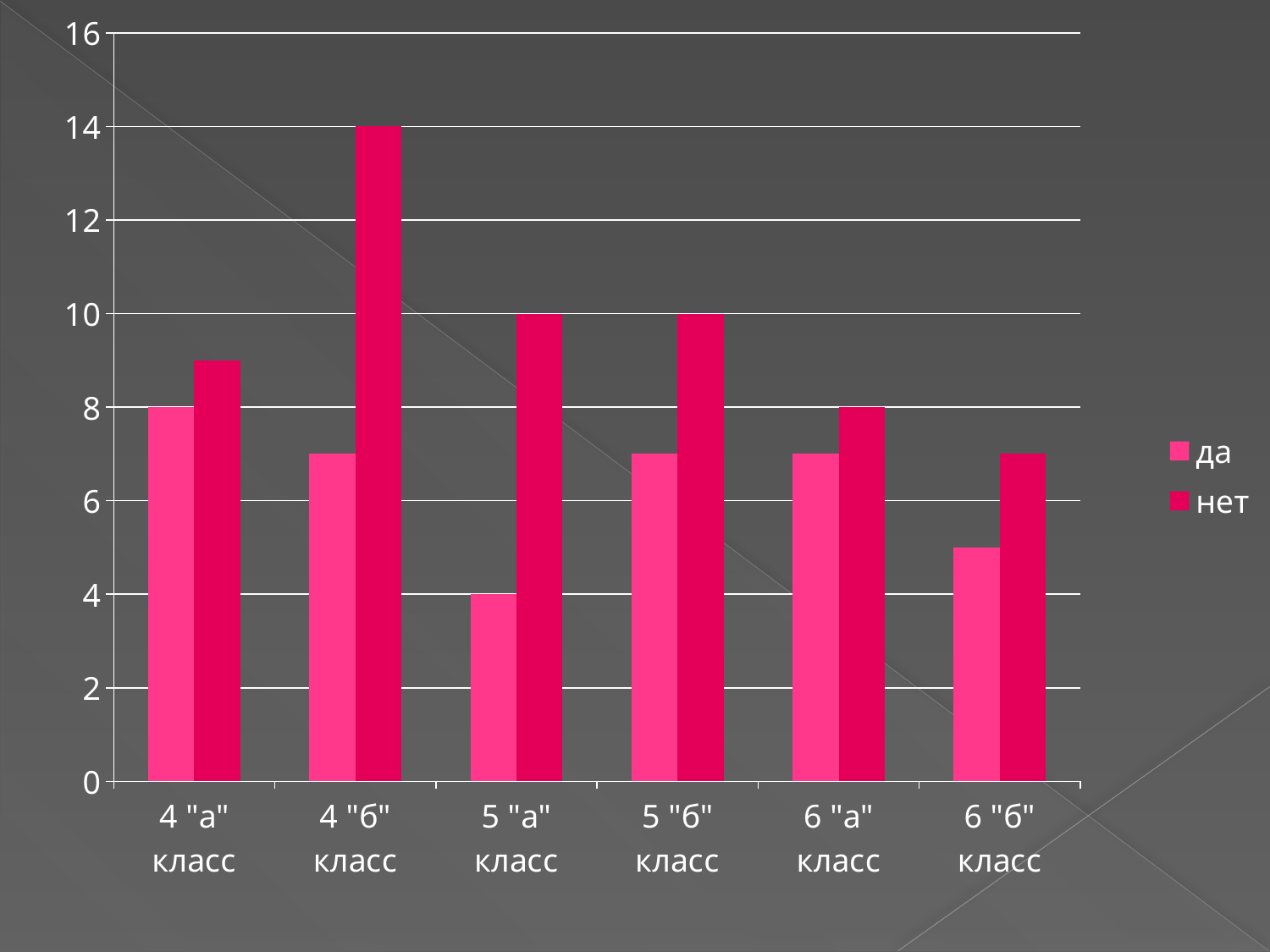
Is the value of "да" for 6 "б" класс greater or less than 6? less What is the value of "нет" for 5 "б" класс? 10 Which is larger: "нет" for 4 "б" класс or "нет" for 6 "а" класс? "нет" for 4 "б" класс How many series does the legend list? 2 What is the difference between "нет" and "да" for 5 "а" класс? 6 What is the value of "нет" for 4 "б" класс? 14 How many classes (categories) are shown on the x axis? 6 What is the value of "да" for 5 "а" класс? 4 Which class has the lowest value for "да"? 5 "а" класс What kind of chart is shown on the slide? bar chart What is the value of "да" for 4 "а" класс? 8 Which class has the highest value for "нет"? 4 "б" класс